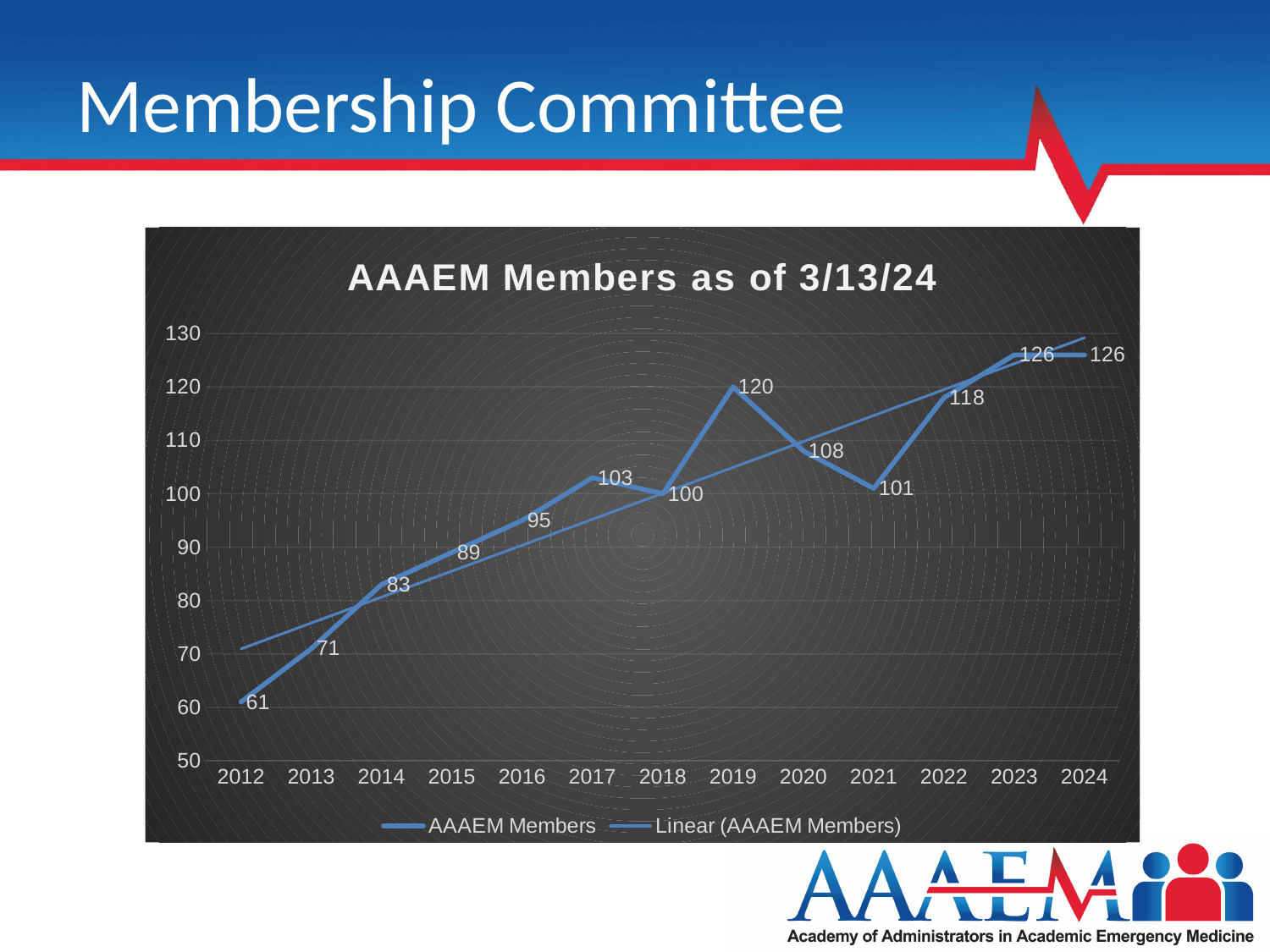
Which year has the lowest number of AAAEM members? 2012 How many series does the legend list? 2 What is the title of the chart? AAAEM Members as of 3/13/24 What is the difference in AAAEM members between 2019 and 2018? 20 What is the value for AAAEM Members in 2021? 101 What kind of chart is shown on the slide? line chart What is the value for AAAEM Members in 2019? 120 Which year had more AAAEM members, 2020 or 2021? 2020 What is the difference in AAAEM members between 2024 and 2012? 65 Overall, do the AAAEM Members values rise or fall from 2012 to 2024? rise How many AAAEM members were there in 2012? 61 How many years are shown on the x axis? 13